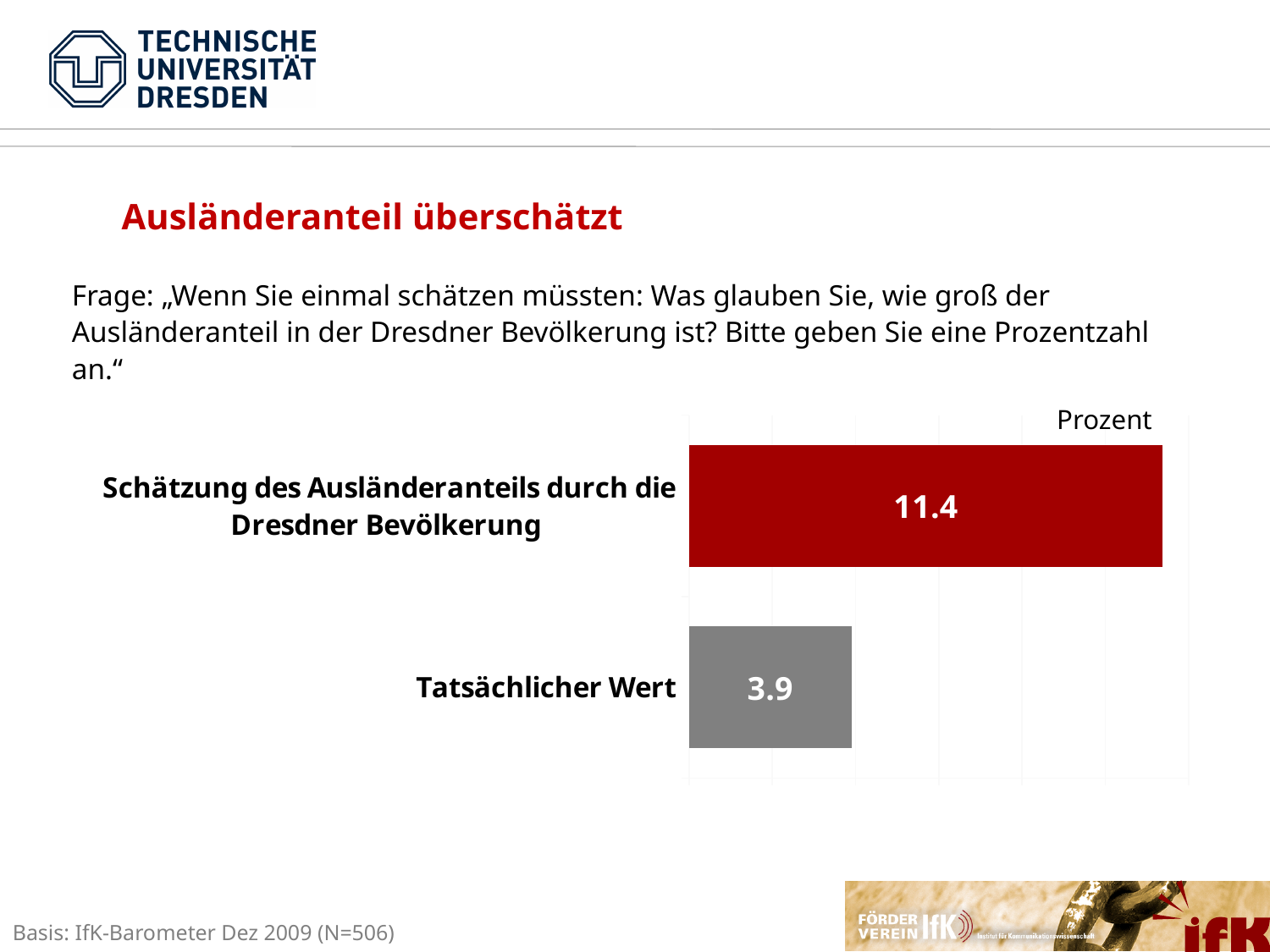
Which is larger: the value for "Schätzung des Ausländeranteils durch die Dresdner Bevölkerung" or for "Tatsächlicher Wert"? Schätzung des Ausländeranteils durch die Dresdner Bevölkerung How many categories are shown in the chart? 2 What is the value for "Tatsächlicher Wert"? 3.9 What colour is the bar for "Tatsächlicher Wert"? Grey What is the value for "Schätzung des Ausländeranteils durch die Dresdner Bevölkerung"? 11.4 Which category has the highest value? Schätzung des Ausländeranteils durch die Dresdner Bevölkerung What kind of chart is shown on the slide? Bar chart Which category has the lowest value? Tatsächlicher Wert What is the difference between the estimated share (11.4) and the actual value (3.9)? 7.5 What unit label is shown above the chart? Prozent